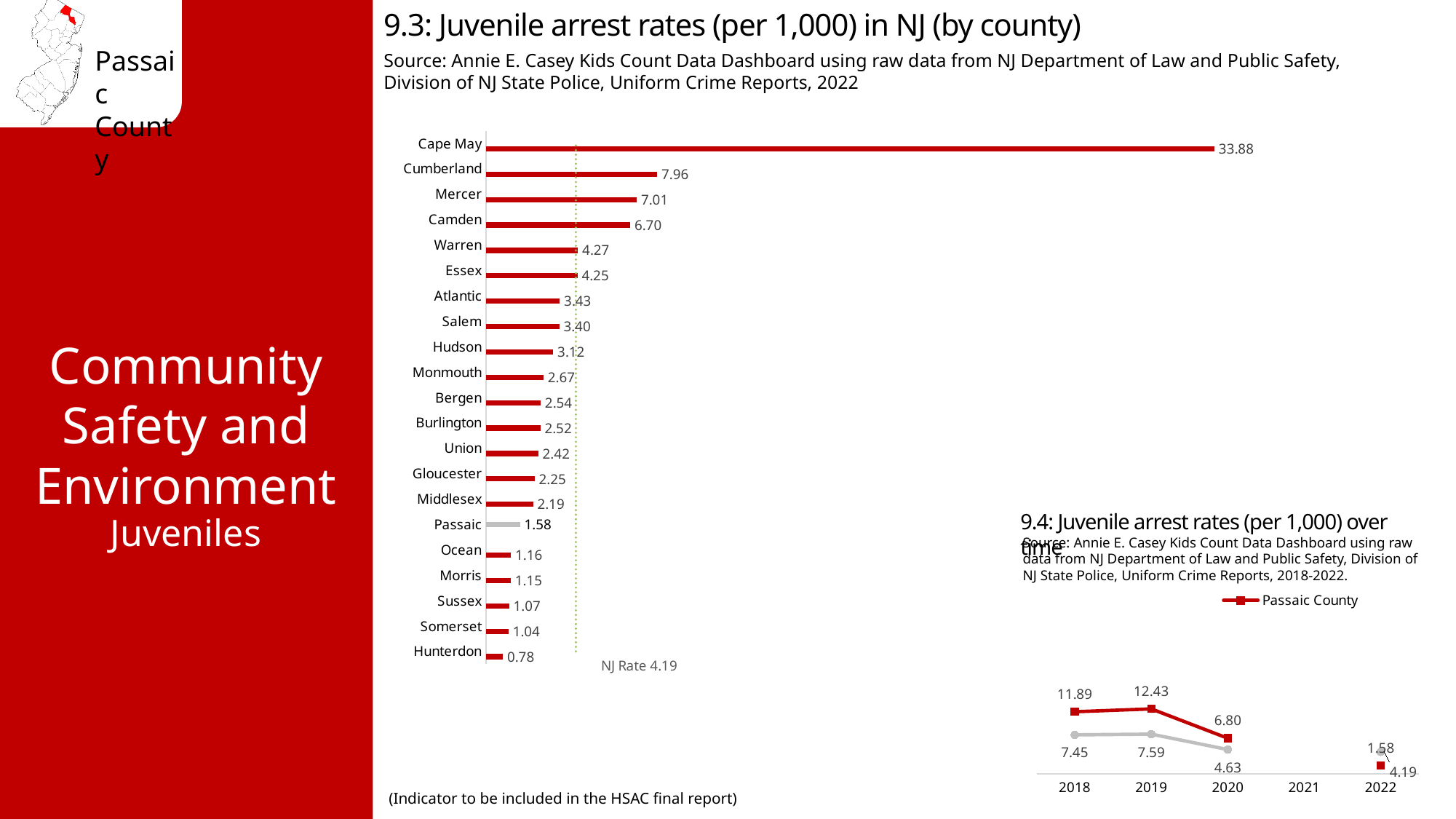
In chart 9.4 (juvenile arrest rates over time), what is the difference between the Passaic County values for 2018 and 2020? 5.09 In chart 9.3 (juvenile arrest rates by county), what is the value for Passaic? 1.58 In chart 9.4 (juvenile arrest rates over time), what is the Passaic County value for 2019? 12.43 What kind of chart is chart 9.3 (juvenile arrest rates by county)? Bar chart In chart 9.3 (juvenile arrest rates by county), which county has the lowest rate? Hunterdon In chart 9.3 (juvenile arrest rates by county), which is larger, Camden or Warren? Camden In chart 9.3 (juvenile arrest rates by county), which county has the highest rate? Cape May In chart 9.3 (juvenile arrest rates by county), what NJ rate is marked by the dotted line? 4.19 In chart 9.3 (juvenile arrest rates by county), what is the value for Cape May? 33.88 In chart 9.4 (juvenile arrest rates over time), does the Passaic County rate rise or fall from 2019 to 2022? Fall In chart 9.3 (juvenile arrest rates by county), what is the difference between Cumberland and Mercer? 0.95 In chart 9.3 (juvenile arrest rates by county), how many counties are shown? 21